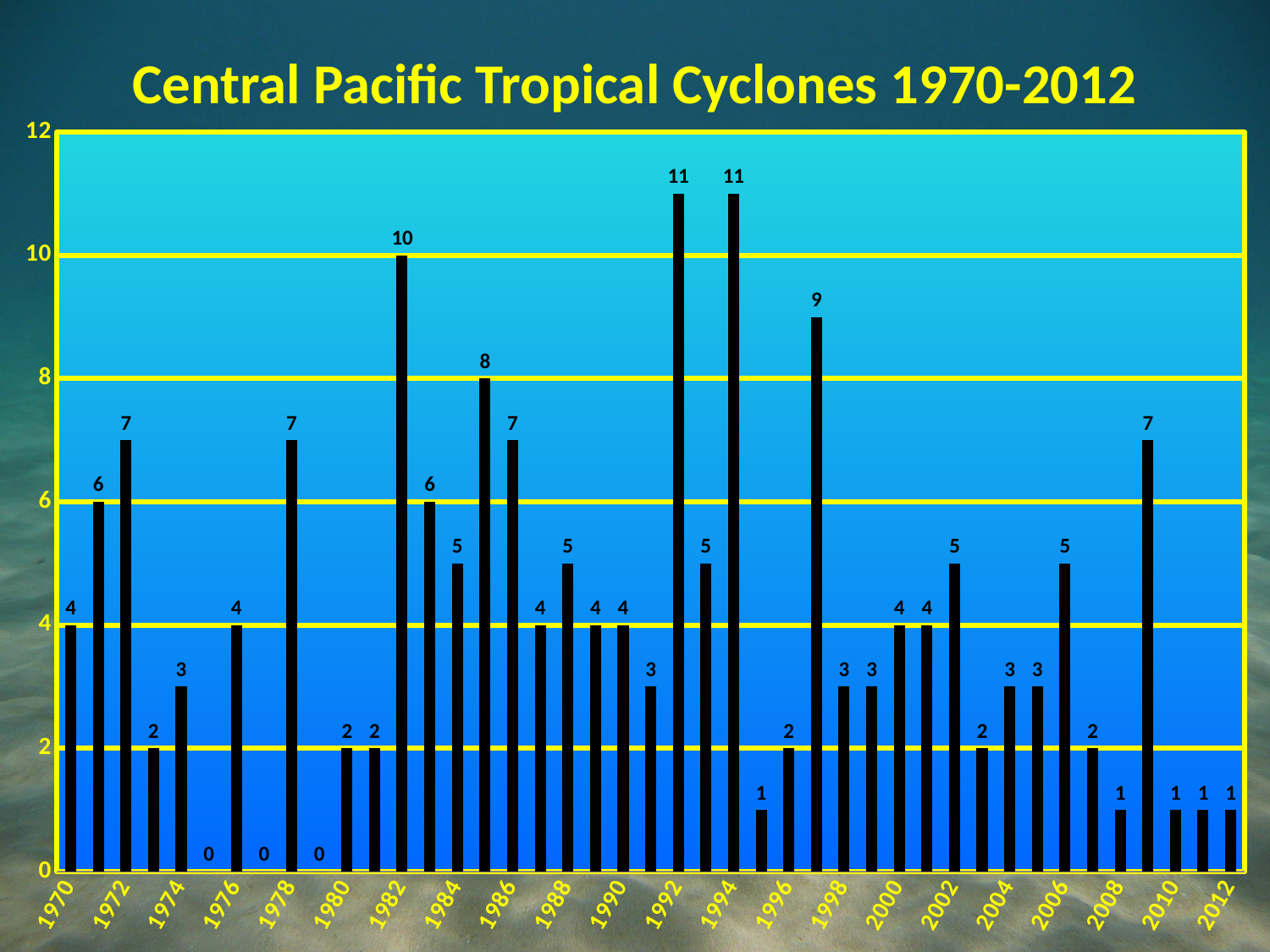
How many years (bars) are plotted on the chart? 43 What is the difference between the values for 1982 and 1970? 6 What is the lowest value shown on the chart? 0 What is the title of the chart? Central Pacific Tropical Cyclones 1970-2012 What is the value for 1978? 7 Which year has the larger value, 1982 or 1978? 1982 What type of chart is shown on the slide? bar chart What is the value for 2012? 1 What is the highest value shown on the chart? 11 How many tropical cyclones are shown for 1982? 10 Is the value for 1992 greater or less than 10? greater What is the value for 1970? 4